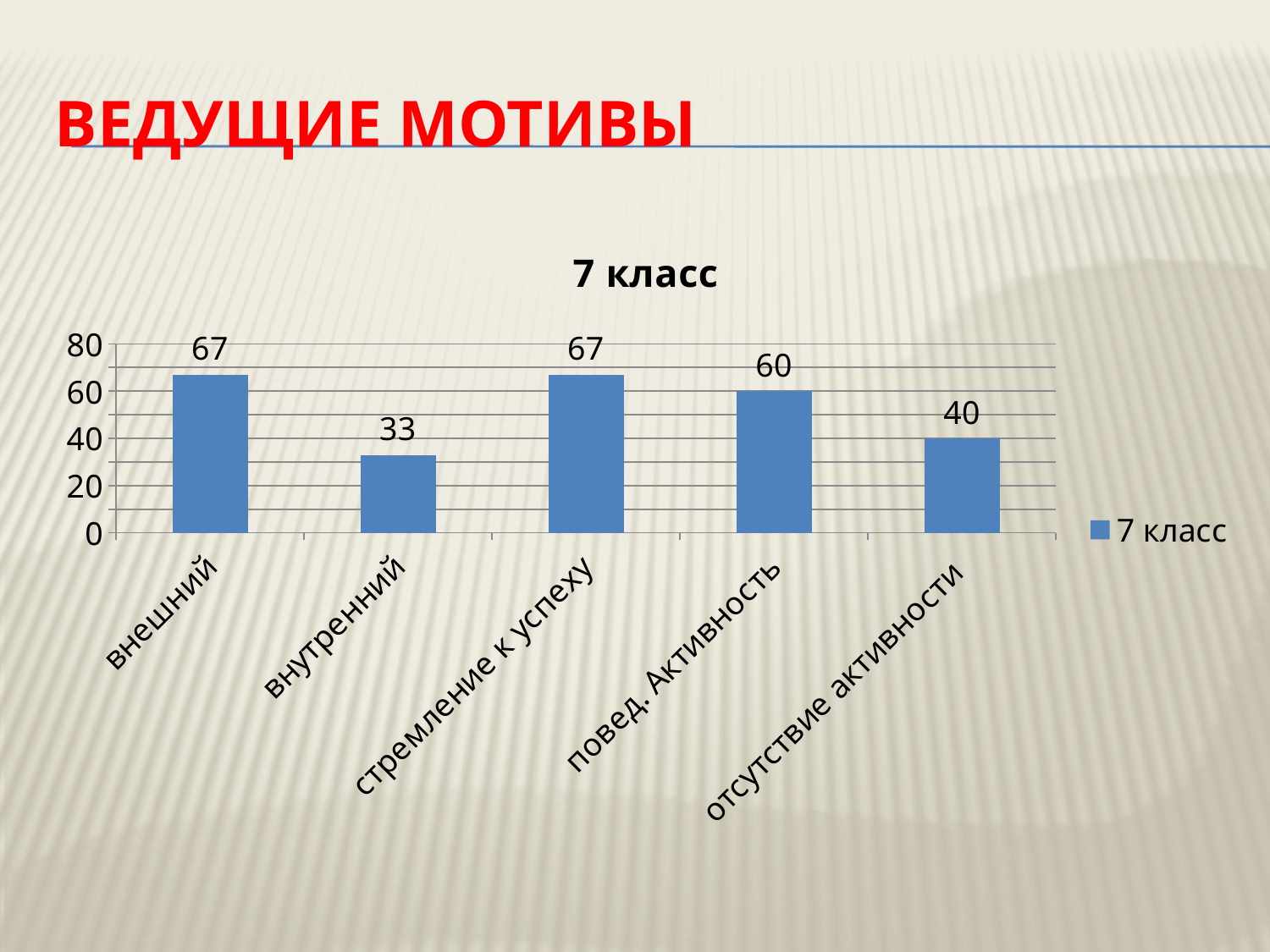
Which is larger, the value for стремление к успеху or the value for повед. Активность? стремление к успеху What is the value for внутренний? 33 What is the difference between the values for внешний and внутренний? 34 What is the value for отсутствие активности? 40 What is the title of the chart? 7 класс How many categories are shown on the x axis? 5 How many series does the legend list? 1 Which category has the lowest value? внутренний What kind of chart is shown? bar chart What is the value for повед. Активность? 60 What is the difference between the values for повед. Активность and отсутствие активности? 20 What is the value for внешний? 67